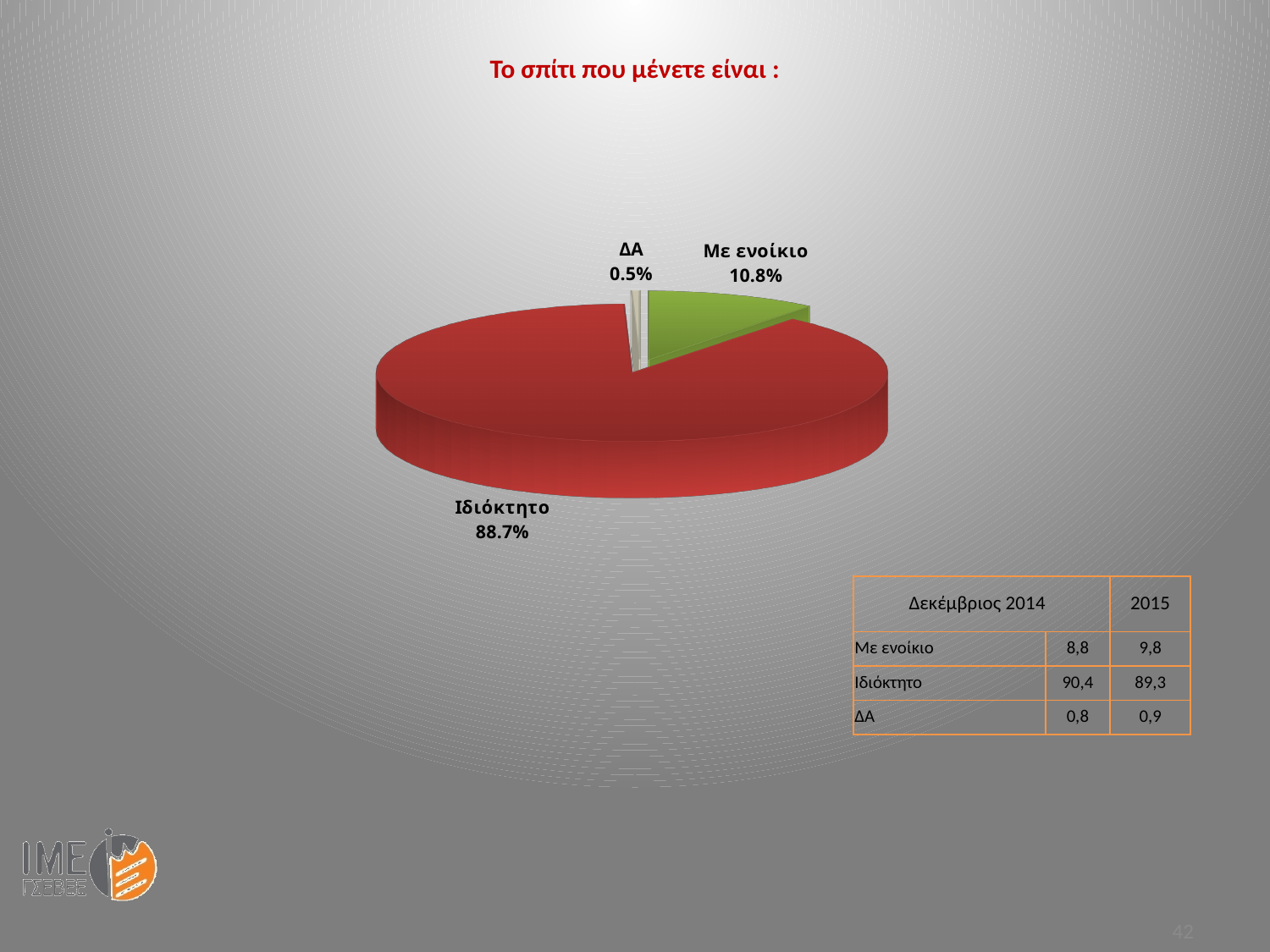
What kind of chart is shown on the slide? Pie chart What is the difference between the values for Ιδιόκτητο and Με ενοίκιο? 77.9% What colour is the Ιδιόκτητο slice? Red Which category has the largest slice of the pie? Ιδιόκτητο Which category has the smallest slice of the pie? ΔΑ What is the value shown for ΔΑ? 0.5% What is the title of the chart? Το σπίτι που μένετε είναι : What share of the pie does Ιδιόκτητο represent? 88.7% What is the value shown for Με ενοίκιο? 10.8% How many slices does the pie chart have? 3 Which is larger, the value for Με ενοίκιο or the value for ΔΑ? Με ενοίκιο What is the difference between the values for Με ενοίκιο and ΔΑ? 10.3%